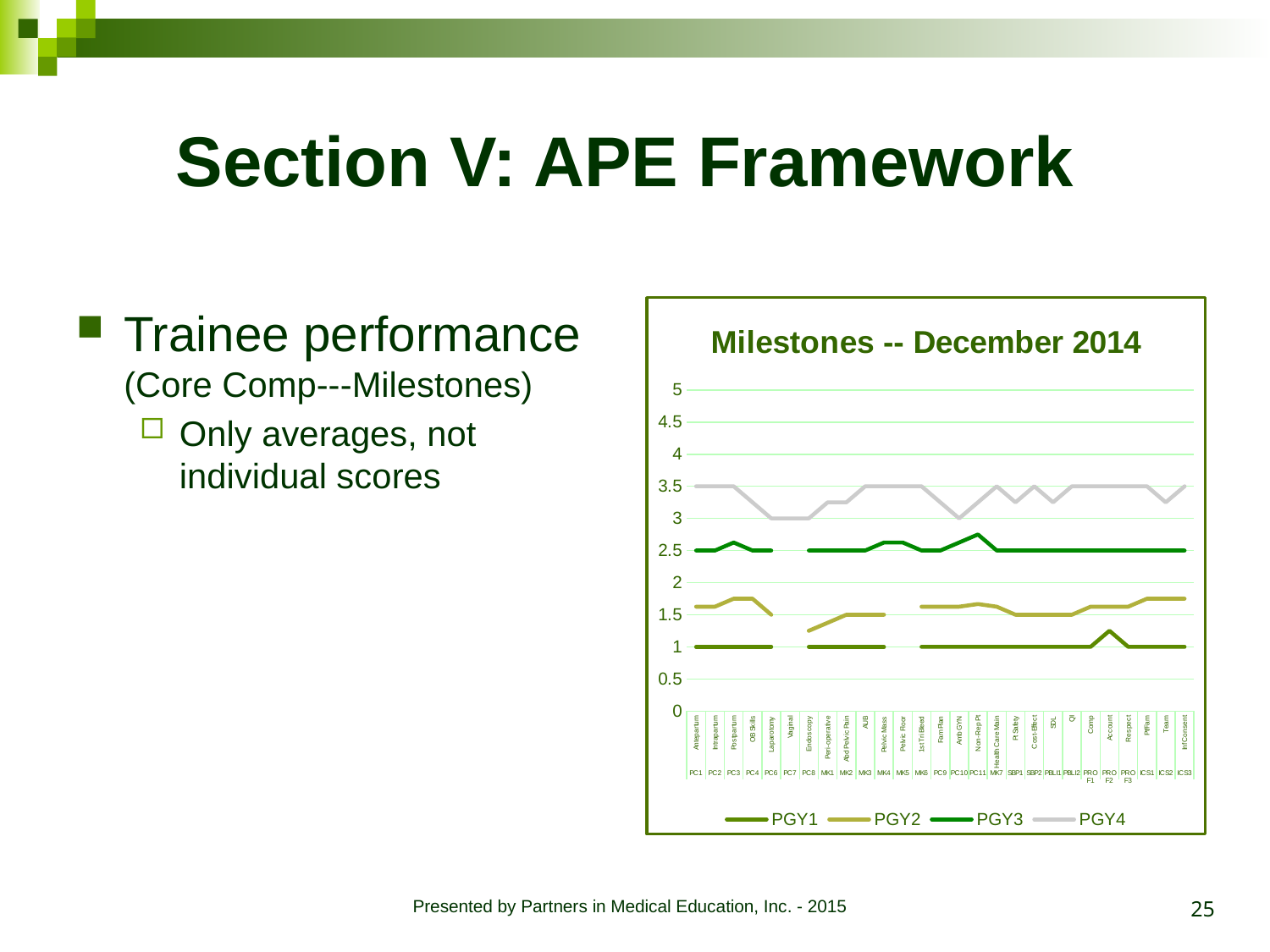
Is the PGY4 value for Laparotomy (PC6) greater or less than 3.5? less Which series does the legend list last in the Milestones chart? PGY4 What is the title of the chart on the slide? Milestones -- December 2014 How many series does the legend of the Milestones chart list? 4 What kind of chart is shown on the slide? line chart What is the PGY4 value for Antepartum (PC1)? 3.5 Which series has the highest values across the Milestones chart? PGY4 Is the PGY2 value for Antepartum (PC1) greater or less than 2? less At Antepartum (PC1), which is larger: the PGY4 value or the PGY1 value? PGY4 What is the PGY1 value for Antepartum (PC1)? 1 Which series has the lowest values across the Milestones chart? PGY1 What is the PGY3 value for Antepartum (PC1)? 2.5